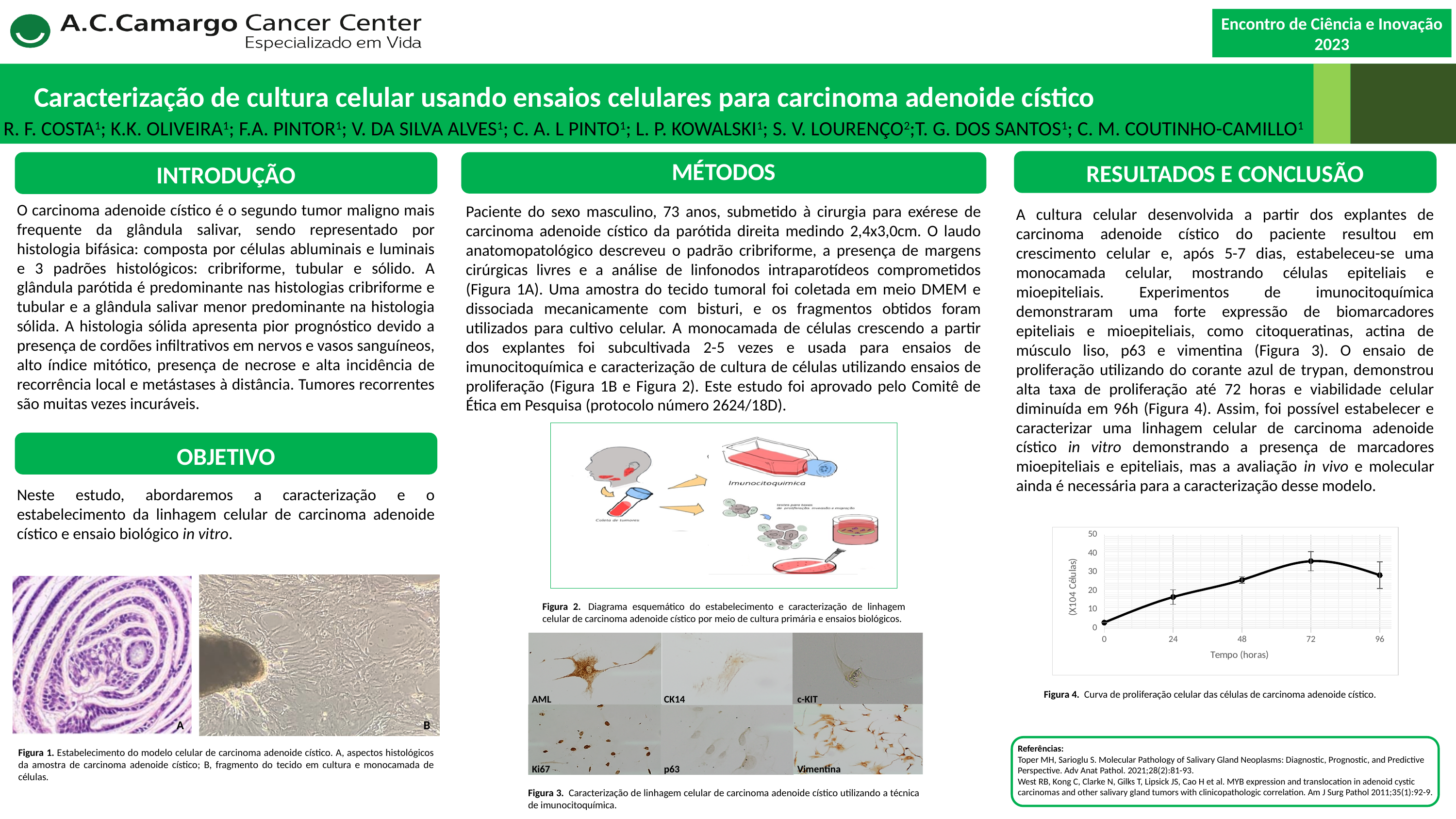
In the Figura 4 chart, is the value at 72 hours greater or less than 30? greater In the Figura 4 chart, is the value at 96 hours greater or less than 20? greater In the Figura 4 chart, is the value at 0 hours greater or less than 10? less At which time point (in hours) does the Figura 4 curve reach its highest value? 72 What kind of chart is shown in Figura 4? line chart How many time points are plotted on the x axis of the Figura 4 chart? 5 At which time point (in hours) is the Figura 4 curve at its lowest value? 0 What is the x-axis label of the Figura 4 chart? Tempo (horas) In the Figura 4 chart, which is larger: the value at 24 hours or the value at 48 hours? 48 hours In the Figura 4 chart, which is larger: the value at 72 hours or the value at 96 hours? 72 hours Does the Figura 4 curve rise or fall between 0 and 72 hours? rise